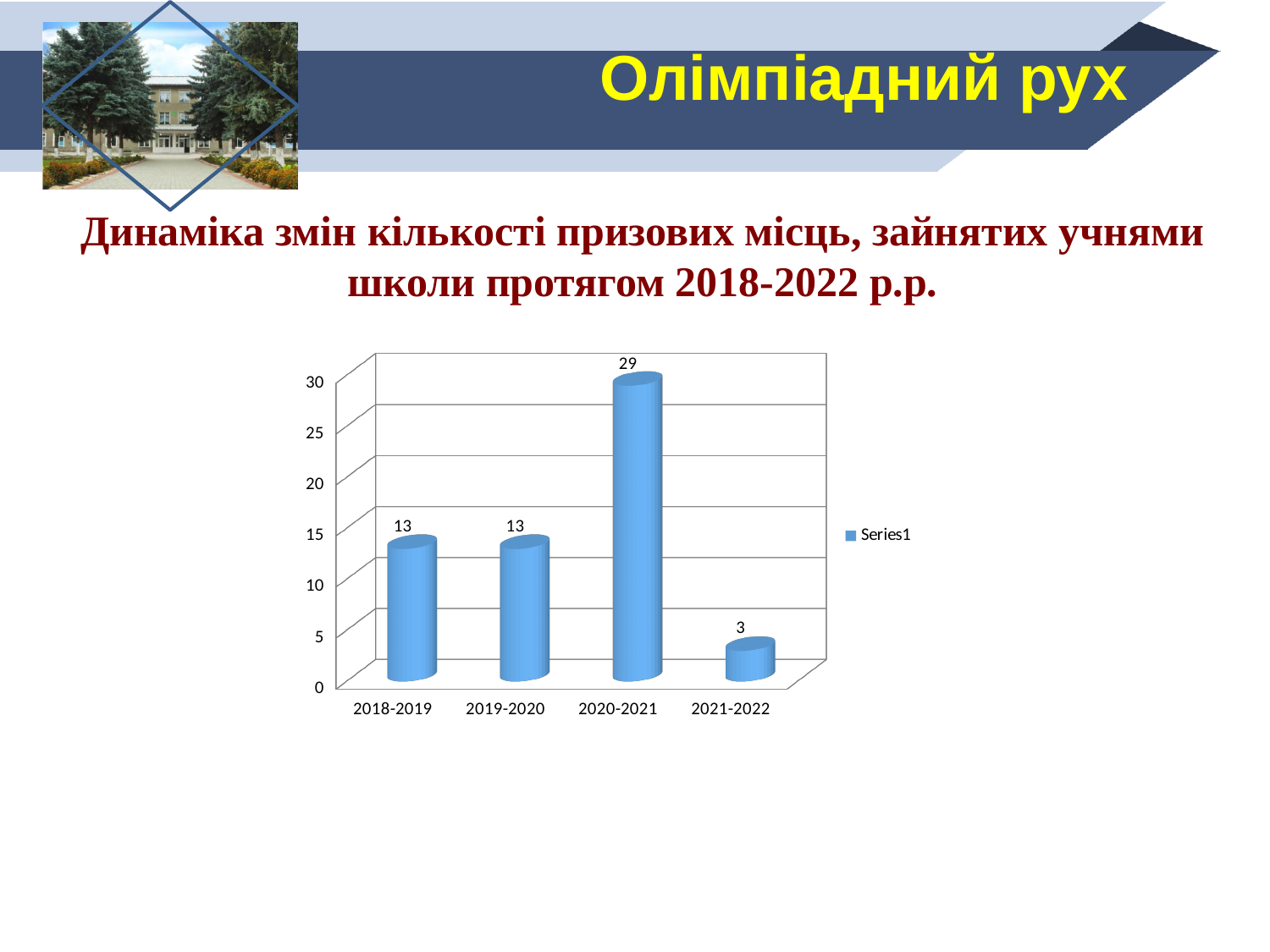
Which category has the highest value? 2020-2021 What is the value for 2021-2022? 3 What is the value for 2020-2021? 29 How many series does the legend list? 1 Which category has the lowest value? 2021-2022 What is the value for 2018-2019? 13 What is the difference between the values for 2020-2021 and 2019-2020? 16 Which is larger, the value for 2019-2020 or the value for 2021-2022? 2019-2020 What is the difference between the values for 2020-2021 and 2021-2022? 26 What kind of chart is shown on the slide? bar chart How many categories are shown on the x axis? 4 What is the legend entry shown next to the chart? Series1